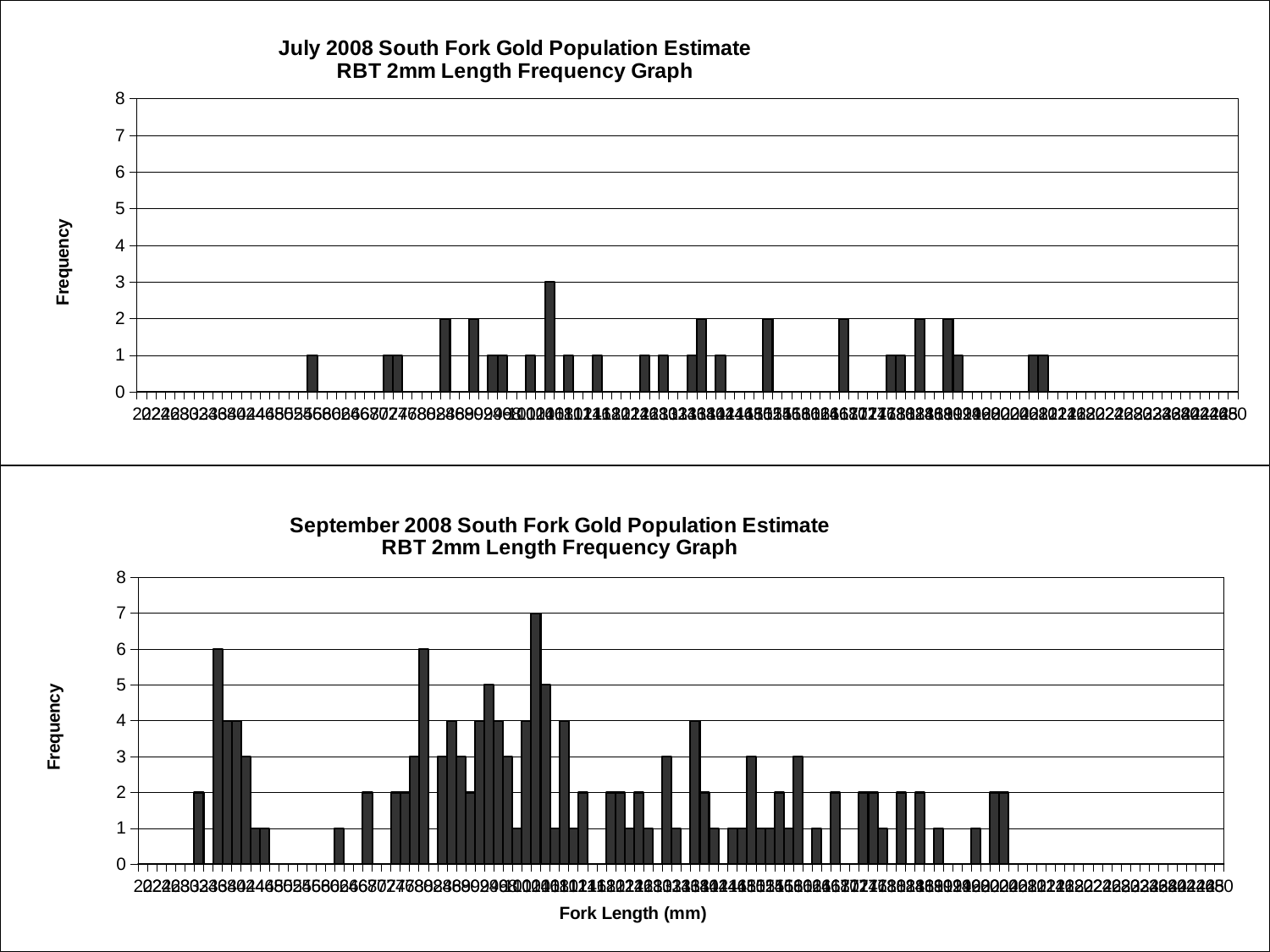
In the July 2008 chart, what is the highest frequency reached by any bar? 3 Which chart has the taller maximum bar, the July 2008 chart or the September 2008 chart? September 2008 What kind of chart is the September 2008 South Fork Gold Population Estimate chart? bar chart What is the label on the vertical axis of the July 2008 chart? Frequency What is the difference between the tallest bar in the September 2008 chart and the tallest bar in the July 2008 chart? 4 What is the label on the horizontal axis of the September 2008 chart? Fork Length (mm) In the July 2008 chart, is the tallest bar greater or less than 5? less What kind of chart is the July 2008 South Fork Gold Population Estimate chart? bar chart In the September 2008 chart, what is the highest frequency reached by any bar? 7 In the September 2008 chart, is the tallest bar greater or less than 5? greater What is the maximum value shown on the vertical axis of the September 2008 chart? 8